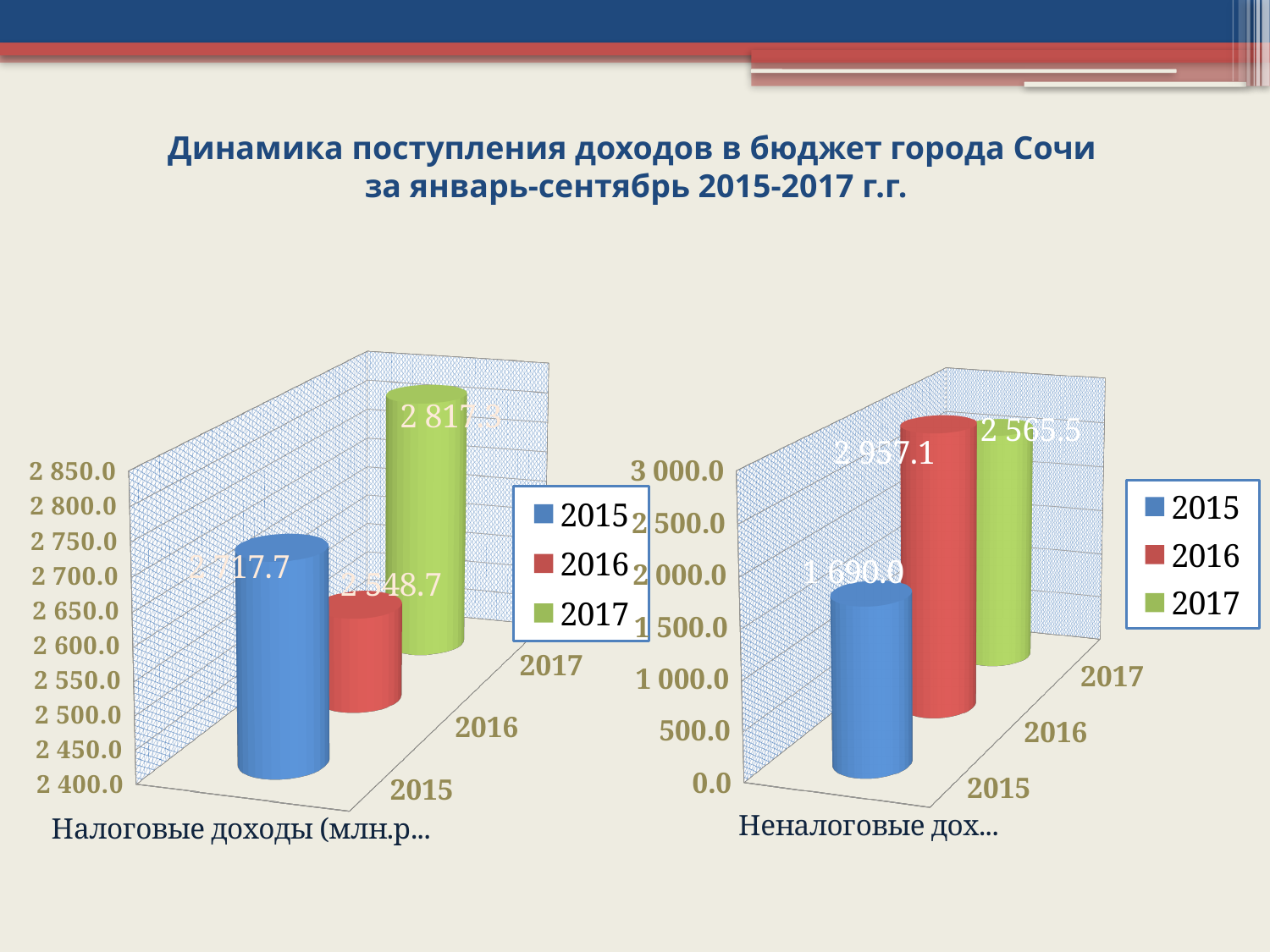
In the right chart (Неналоговые доходы), what is the difference between the 2016 and 2015 values? 1 267.1 In the left chart (Налоговые доходы), what is the value for 2016? 2 548.7 In the left chart (Налоговые доходы), which year has the lowest value? 2016 In the right chart (Неналоговые доходы), which year has the highest value? 2016 In the right chart (Неналоговые доходы), what is the value for 2015? 1 690.0 In the left chart (Налоговые доходы), what is the value for 2015? 2 717.7 What kind of chart is the left chart (Налоговые доходы)? Bar chart How many series does the legend of the right chart (Неналоговые доходы) list? 3 In the right chart (Неналоговые доходы), what is the value for 2016? 2 957.1 In the right chart (Неналоговые доходы), is the value for 2017 greater or less than 2 000.0? greater In the left chart (Налоговые доходы), which is larger, the value for 2015 or the value for 2016? 2015 How many bars are plotted in the left chart (Налоговые доходы)? 3